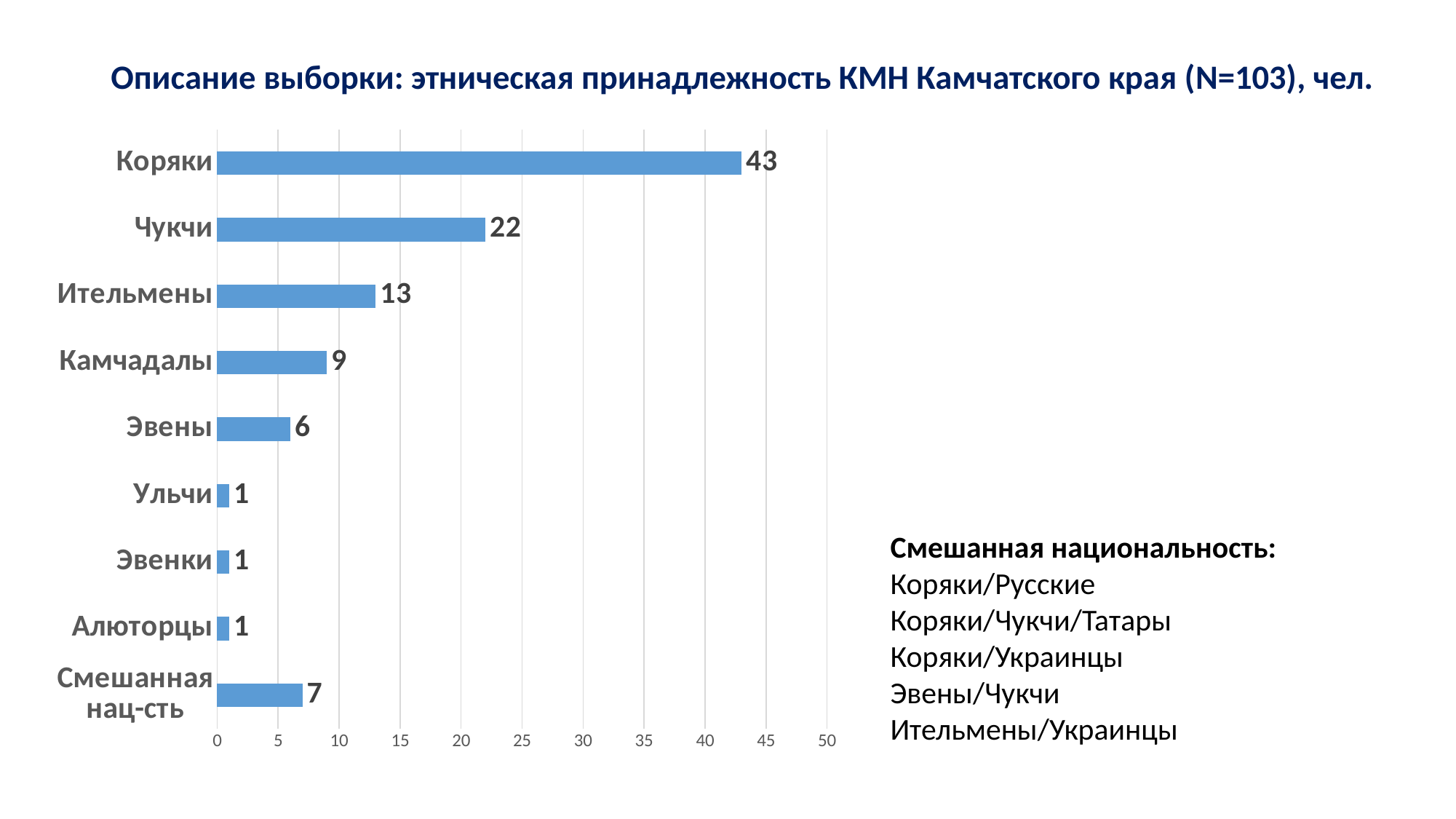
What is the difference between the values for Камчадалы and Эвены? 3 Is the value for Чукчи greater or less than 20? greater What is the value for Ительмены? 13 What kind of chart is shown on the slide? bar chart What is the difference between the values for Коряки and Чукчи? 21 Which is larger, the value for Ительмены or the value for Камчадалы? Ительмены What is the value for Смешанная нац-сть? 7 How many categories have a value of 1? 3 How many categories are shown in the chart? 9 What is the value for Чукчи? 22 What is the value for Коряки? 43 Which category has the highest value? Коряки